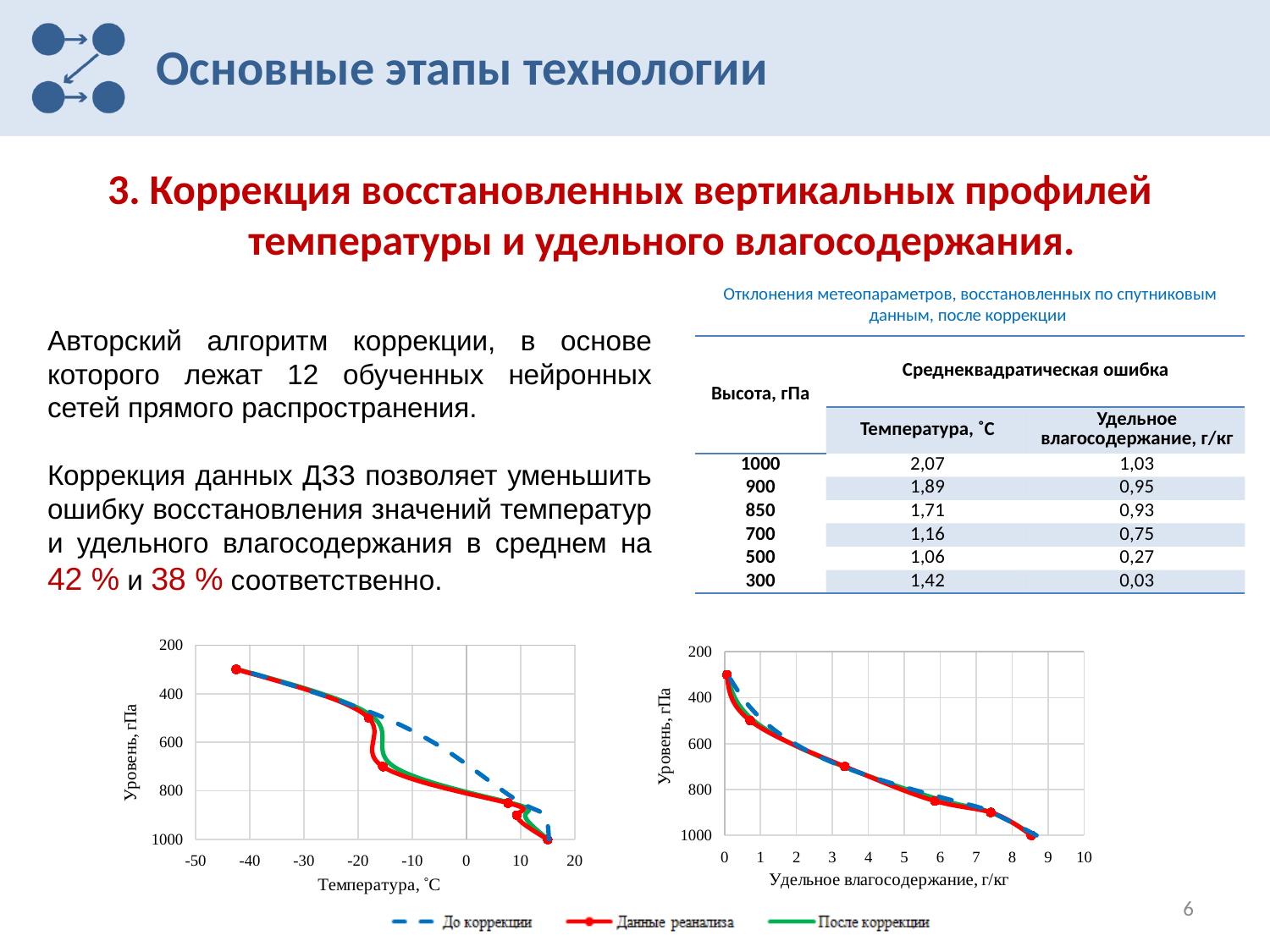
In the right chart, is the specific humidity for Данные реанализа at 1000 гПа greater or less than 8? greater In the right chart, is the specific humidity for Данные реанализа at 900 гПа greater or less than 7? greater In the right chart, at which pressure level is the specific humidity for Данные реанализа highest? 1000 In the left chart, is the temperature for Данные реанализа at 700 гПа greater or less than -10? less How many series does the legend list for the charts? 3 What are the three series named in the legend? До коррекции, Данные реанализа, После коррекции In the right chart, does the specific humidity increase or decrease as the pressure level goes from 1000 to 300 гПа? decrease What kind of chart is the left chart (Температура, ˚C)? line chart What is the x-axis title of the right chart? Удельное влагосодержание, г/кг In the left chart, at 700 гПа, is the temperature for До коррекции higher or lower than for Данные реанализа? higher